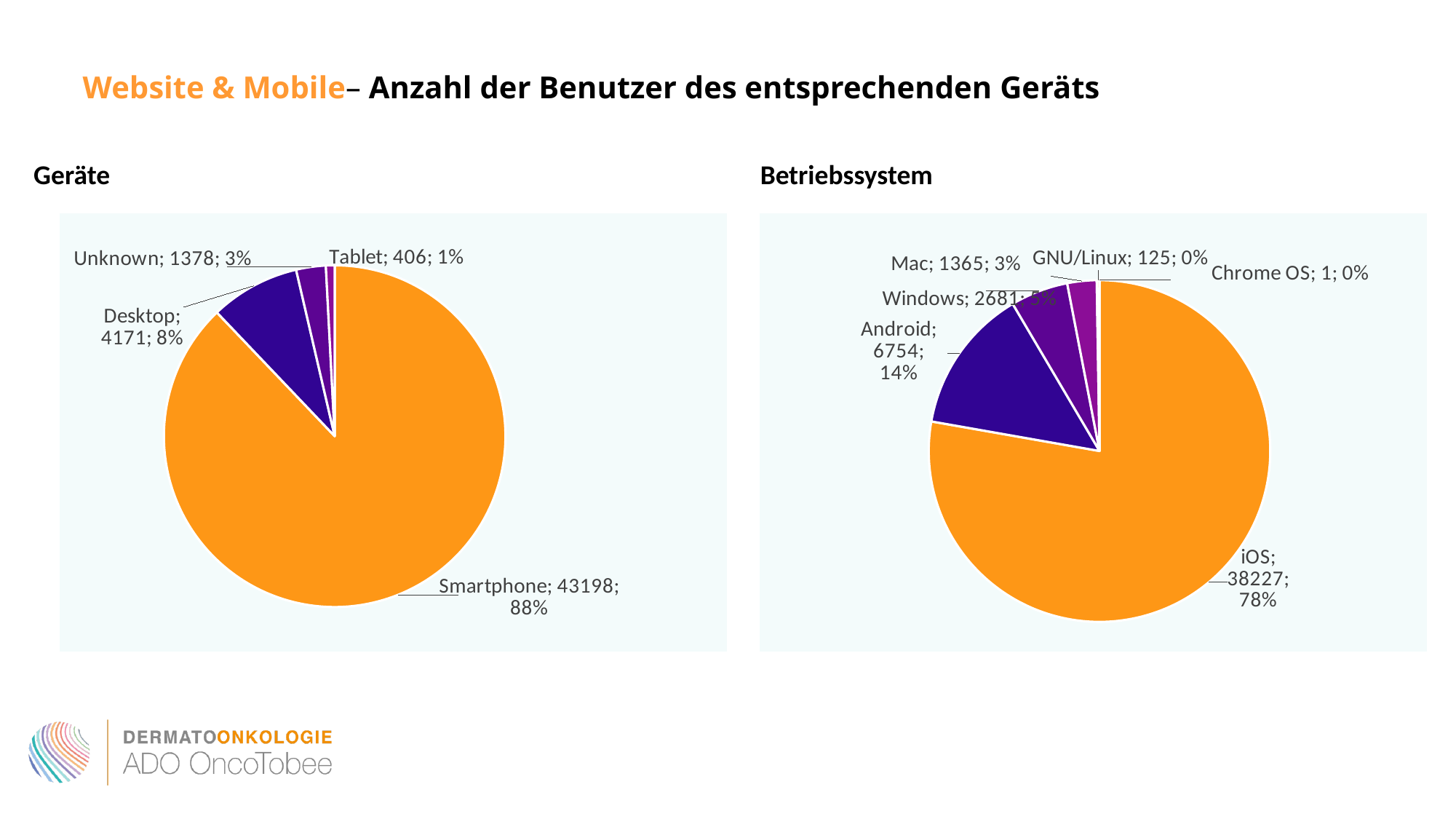
In the "Betriebssystem" chart, which operating system has the largest number of users? iOS In the "Geräte" chart, which category has the smallest number of users? Tablet In the "Geräte" chart, what share of the pie does Desktop have? 8% In the "Betriebssystem" chart, which operating system has the smallest number of users? Chrome OS How many categories are shown in the "Geräte" chart? 4 In the "Geräte" chart, what is the difference in users between Desktop and Unknown? 2793 In the "Betriebssystem" chart, what share of the pie does iOS have? 78% In the "Betriebssystem" chart, how many users are shown for Android? 6754 How many categories are shown in the "Betriebssystem" chart? 6 In the "Betriebssystem" chart, which has more users, Windows or Mac? Windows In the "Geräte" chart, how many users are shown for Smartphone? 43198 What type of chart is the "Geräte" chart? pie chart